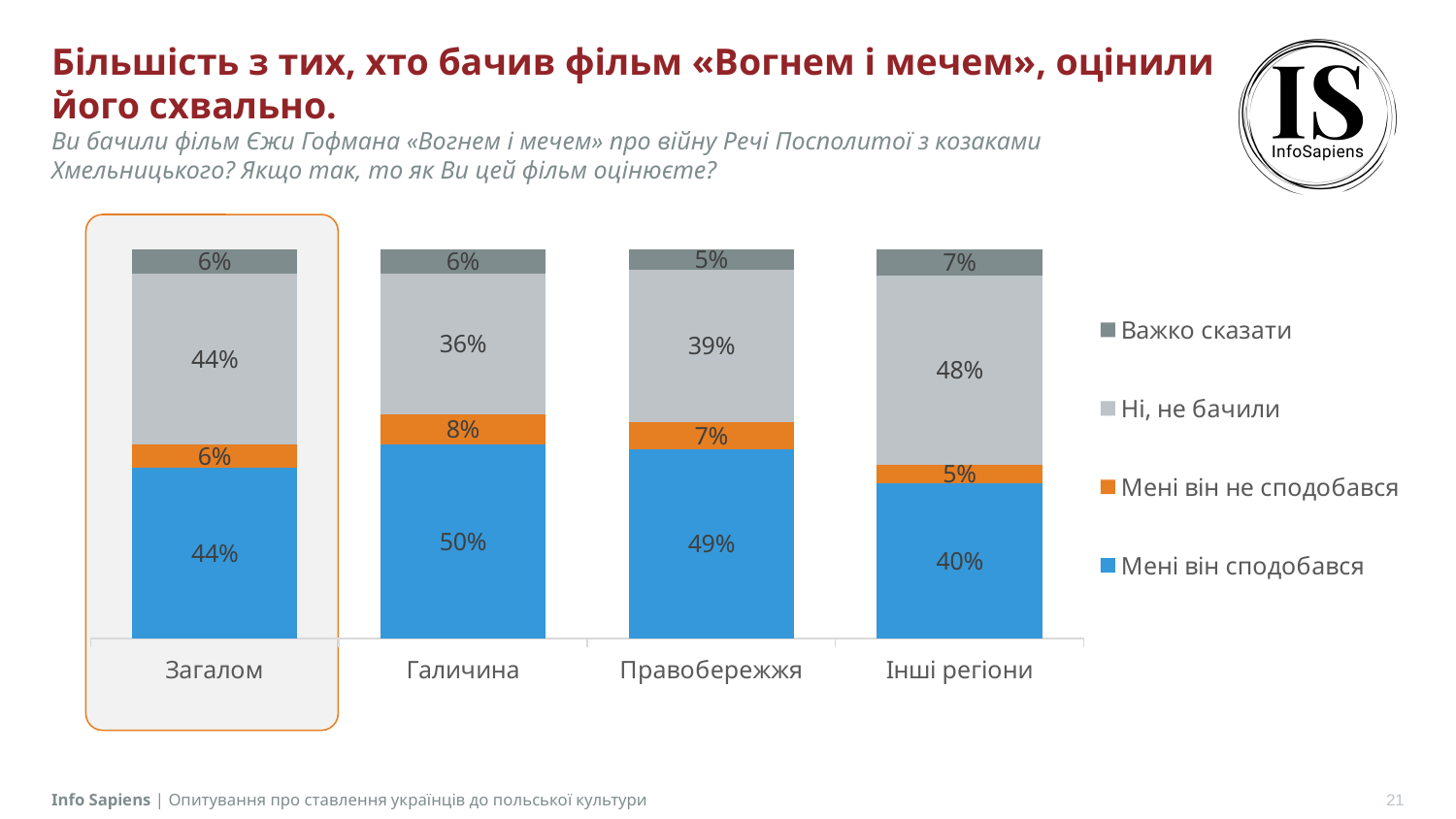
What is the value for «Ні, не бачили» in the Інші регіони bar? 48% What percentage of respondents in Галичина answered «Мені він сподобався»? 50% What is the difference between the «Мені він сподобався» values for Галичина and Інші регіони? 10% What is the «Важко сказати» value for Загалом? 6% How many categories are shown on the x axis? 4 How many series does the legend list? 4 Which category has the highest value for «Мені він сподобався»? Галичина Which is larger: the «Ні, не бачили» value for Правобережжя or for Інші регіони? Інші регіони Which category has the lowest value for «Ні, не бачили»? Галичина What kind of chart is shown on the slide? Stacked bar chart What is the total of the Правобережжя stacked bar? 100% What share of respondents in Правобережжя answered «Мені він не сподобався»? 7%